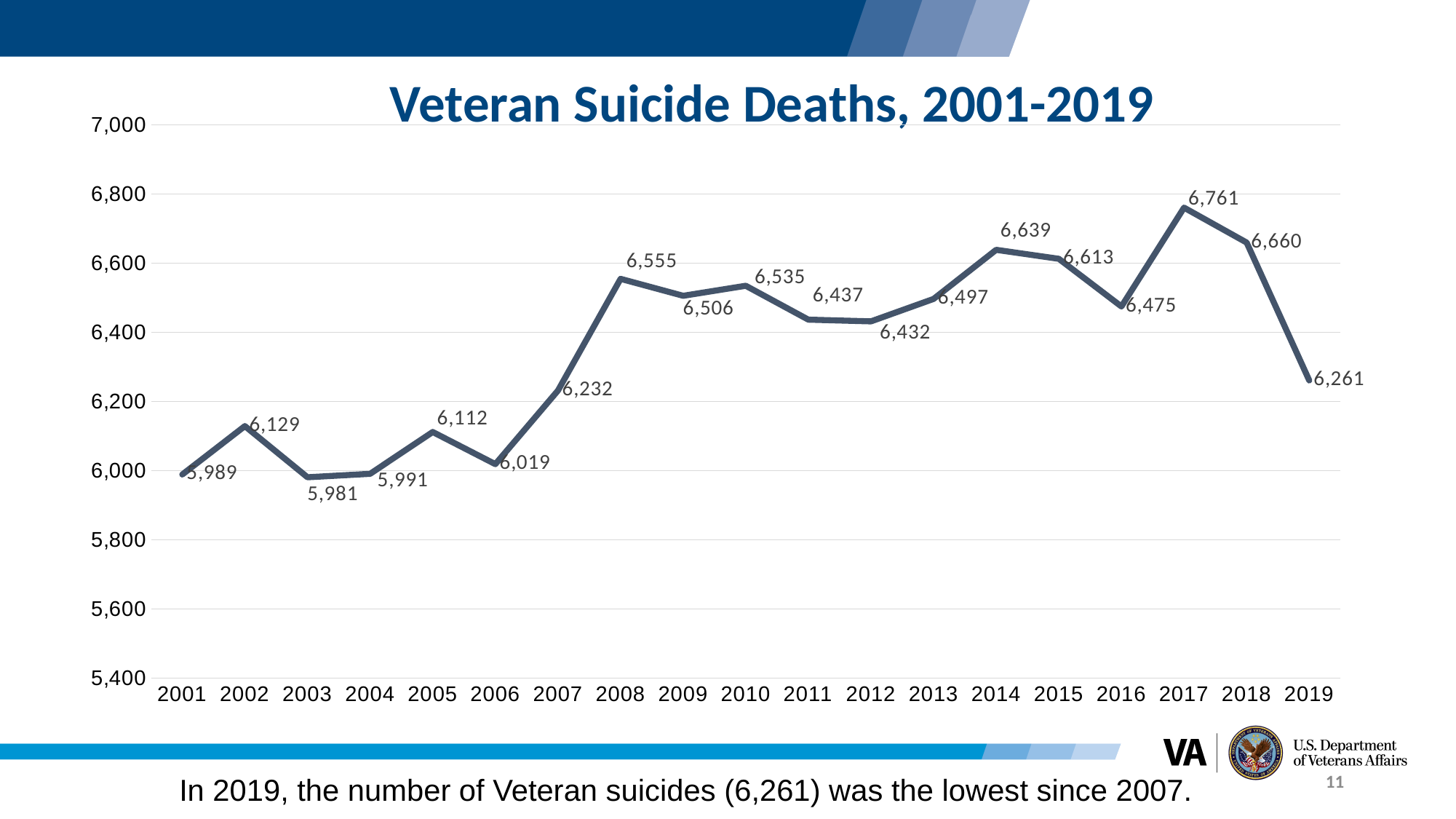
Which year has the highest number of Veteran suicide deaths? 2017 Do the values rise or fall from 2017 to 2019? Fall Which year has the lowest number of Veteran suicide deaths? 2003 What is the title of the chart? Veteran Suicide Deaths, 2001-2019 What kind of chart is shown on the slide? Line chart Which year has more Veteran suicide deaths, 2008 or 2014? 2014 What is the number of Veteran suicide deaths in 2019? 6,261 What is the number of Veteran suicide deaths in 2003? 5,981 Is the value for 2007 greater or less than 6,400? less How many years are plotted on the chart? 19 What is the number of Veteran suicide deaths in 2017? 6,761 What is the difference between the number of Veteran suicide deaths in 2018 and in 2019? 399